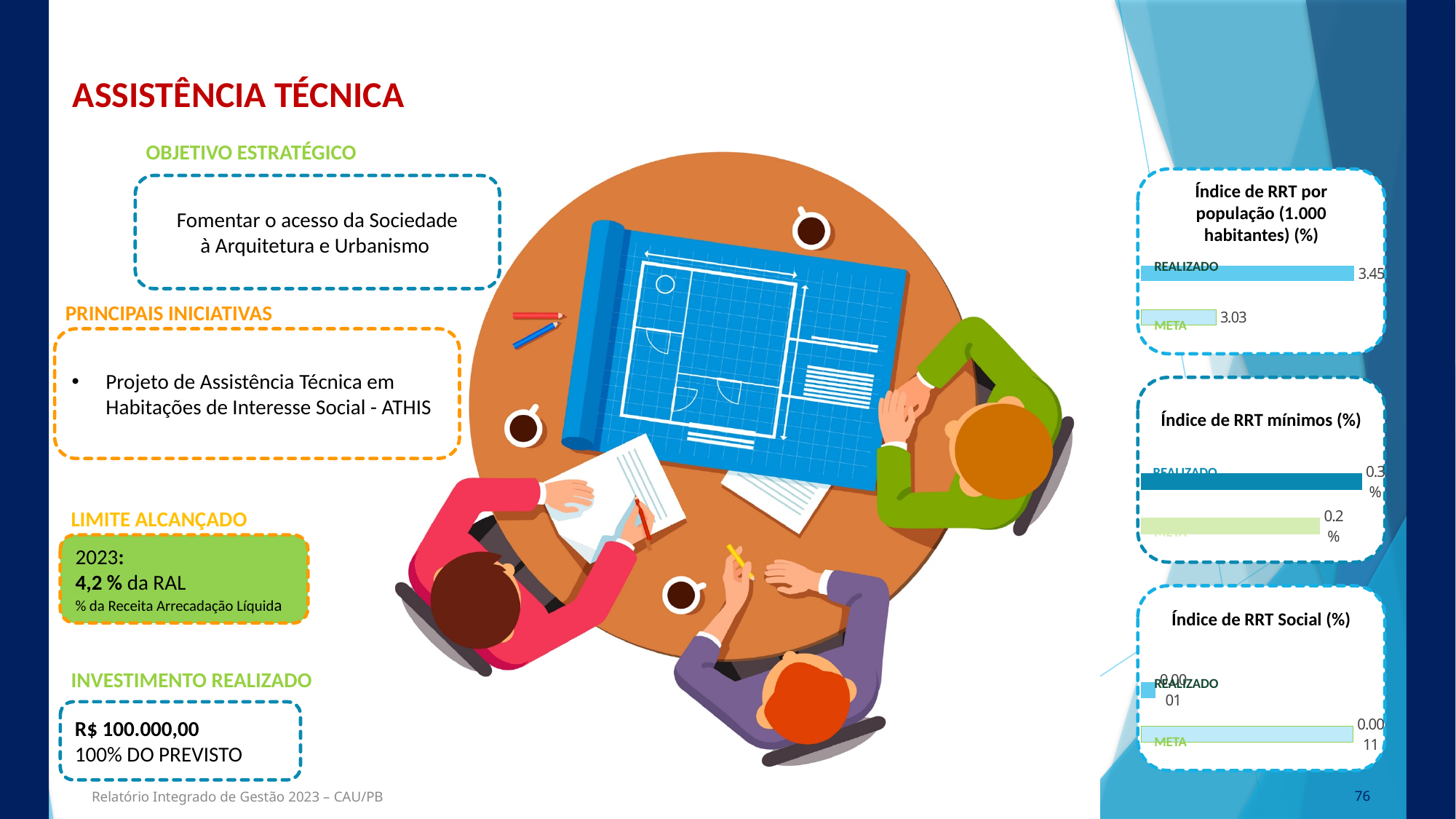
In the chart titled 'Índice de RRT mínimos (%)', what is the value for META? 0.2% In the chart titled 'Índice de RRT mínimos (%)', what is the difference between REALIZADO and META? 0.1% What kind of chart is the one titled 'Índice de RRT por população (1.000 habitantes) (%)'? Bar chart In the chart titled 'Índice de RRT por população (1.000 habitantes) (%)', what is the value for REALIZADO? 3.45 In the chart titled 'Índice de RRT mínimos (%)', what is the value for REALIZADO? 0.3% In the chart titled 'Índice de RRT Social (%)', which category has the lowest value? REALIZADO How many bars are shown in the chart titled 'Índice de RRT mínimos (%)'? 2 In the chart titled 'Índice de RRT Social (%)', which bar is longer, REALIZADO or META? META In the chart titled 'Índice de RRT por população (1.000 habitantes) (%)', what is the value for META? 3.03 In the chart titled 'Índice de RRT mínimos (%)', which category has the highest value? REALIZADO In the chart titled 'Índice de RRT por população (1.000 habitantes) (%)', which bar is longer, REALIZADO or META? REALIZADO In the chart titled 'Índice de RRT por população (1.000 habitantes) (%)', what is the difference between REALIZADO and META? 0.42